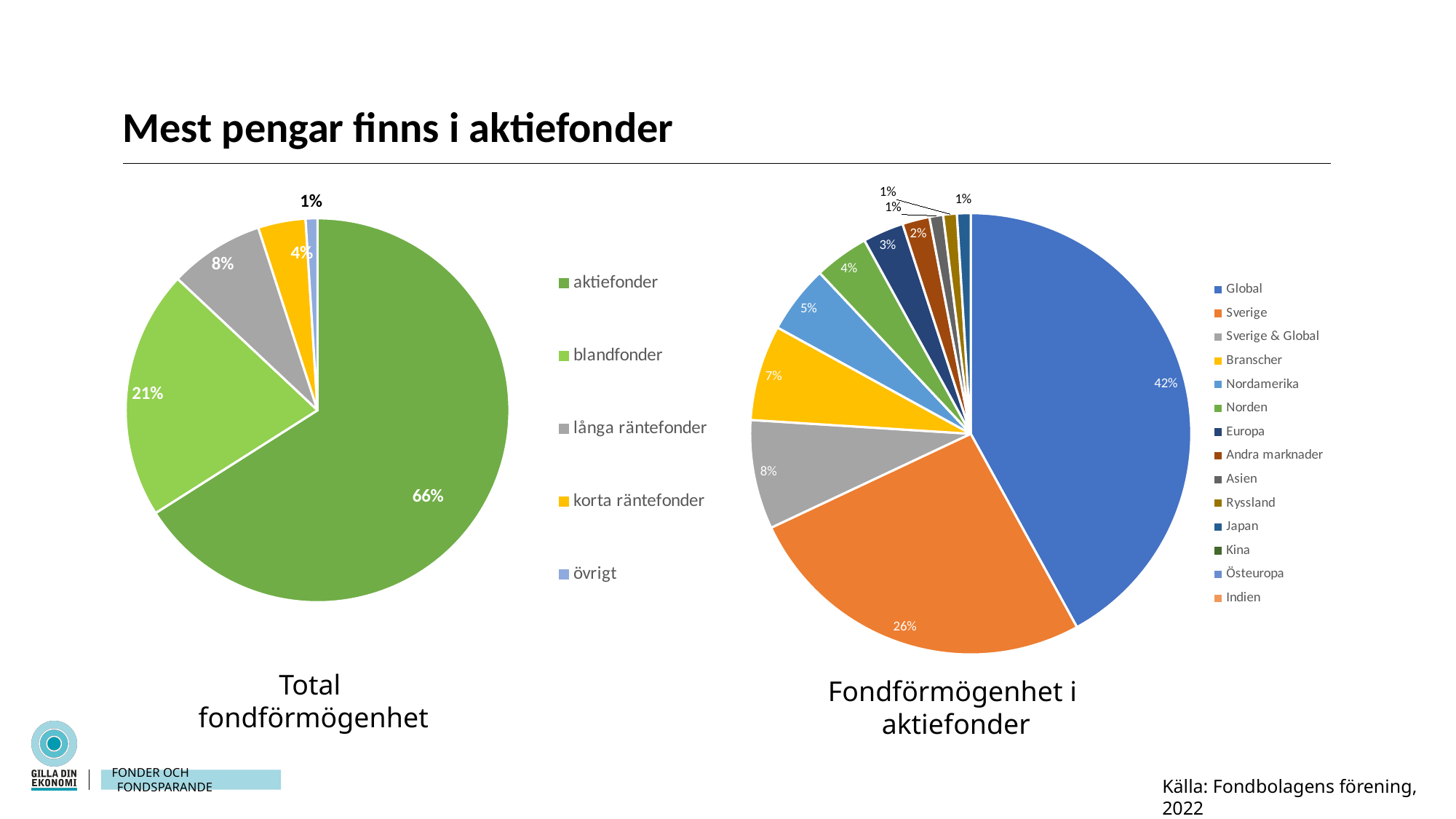
What kind of chart is the 'Total fondförmögenhet' chart? pie chart In the 'Total fondförmögenhet' chart, which category has the largest slice? aktiefonder How many categories does the legend of the 'Total fondförmögenhet' chart list? 5 In the 'Fondförmögenhet i aktiefonder' chart, what is the difference between the shares of Global and Sverige? 16% In the 'Fondförmögenhet i aktiefonder' chart, what share does Global have? 42% In the 'Fondförmögenhet i aktiefonder' chart, which is larger, Branscher or Nordamerika? Branscher In the 'Fondförmögenhet i aktiefonder' chart, what share does Sverige have? 26% How many categories does the legend of the 'Fondförmögenhet i aktiefonder' chart list? 14 In the 'Total fondförmögenhet' chart, what is the difference between the shares of långa räntefonder and korta räntefonder? 4% In the 'Total fondförmögenhet' chart, what share do blandfonder have? 21% In the 'Total fondförmögenhet' chart, which category has the smallest slice? övrigt